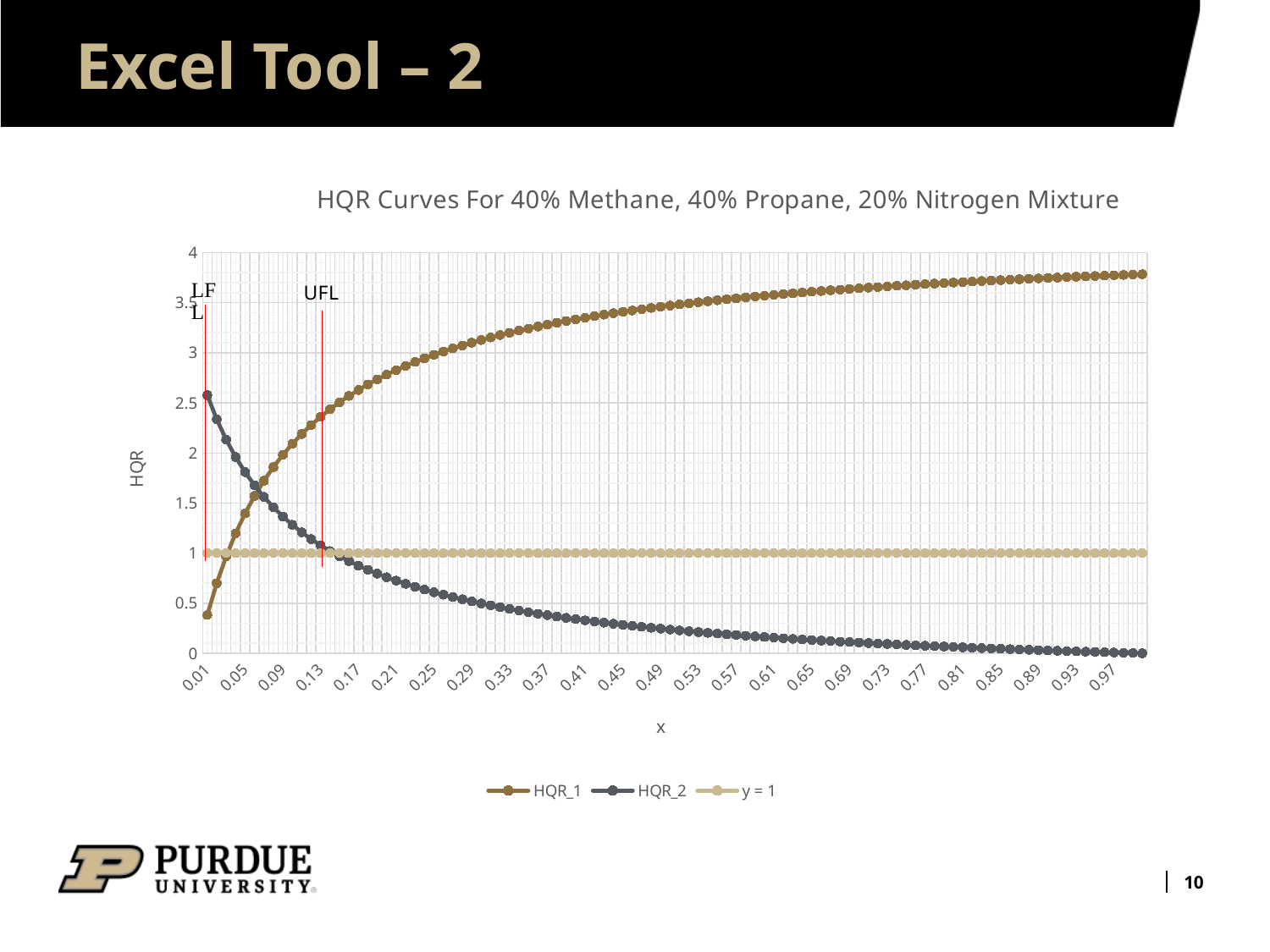
Is the value of HQR_2 at x = 0.97 greater or less than 0.5? less Is the value of HQR_1 at x = 0.97 greater or less than 3.5? greater How many series does the legend list? 3 What kind of chart is shown on the slide? Line chart What is the title of the chart? HQR Curves For 40% Methane, 40% Propane, 20% Nitrogen Mixture What are the names of the three series in the legend? HQR_1, HQR_2, y = 1 At x = 0.97, which series has the larger value, HQR_1 or HQR_2? HQR_1 What is the value of the y = 1 series across the whole x range? 1 Does the HQR_2 series rise or fall as x increases? Falls Is the value of HQR_2 at x = 0.01 greater or less than 2? greater Does the HQR_1 series rise or fall as x increases? Rises